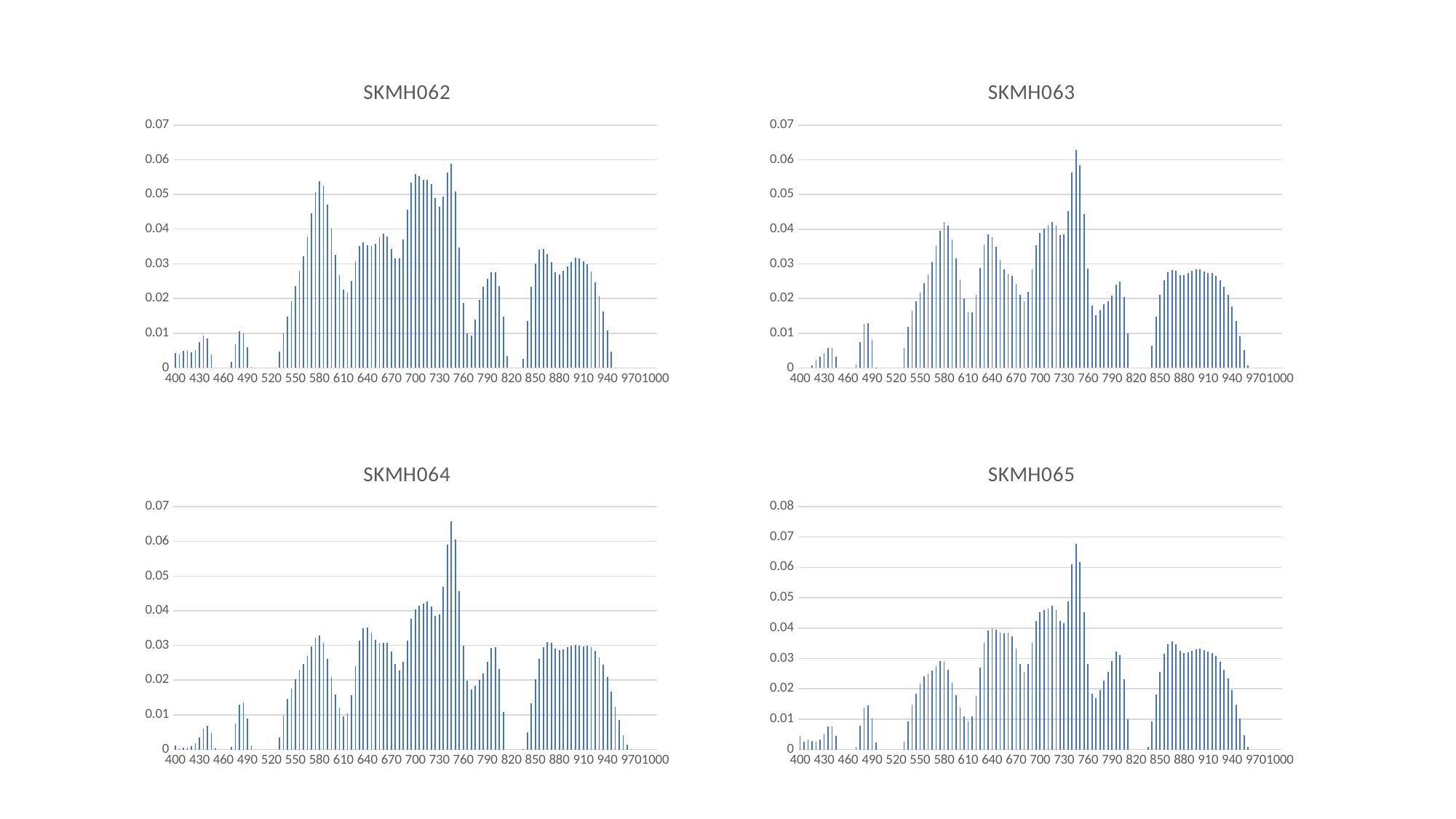
In the SKMH064 chart, are the bars between 850 and 940 on the x axis greater or less than 0.04? less In the SKMH064 chart, is the tallest bar (near 750 on the x axis) greater or less than 0.06? greater How many charts are shown on the slide? 4 In the SKMH065 chart, is the tallest bar (near 750 on the x axis) greater or less than 0.06? greater In the SKMH062 chart, which is larger: the tallest bar near 580 or the tallest bar near 880? the bar near 580 What is the title of the chart in the bottom-right position of the slide? SKMH065 In the SKMH063 chart, which is larger: the tallest bar near 750 or the tallest bar near 580? the bar near 750 What kind of chart is SKMH062? bar chart What is the highest value shown on the y axis of the SKMH065 chart? 0.08